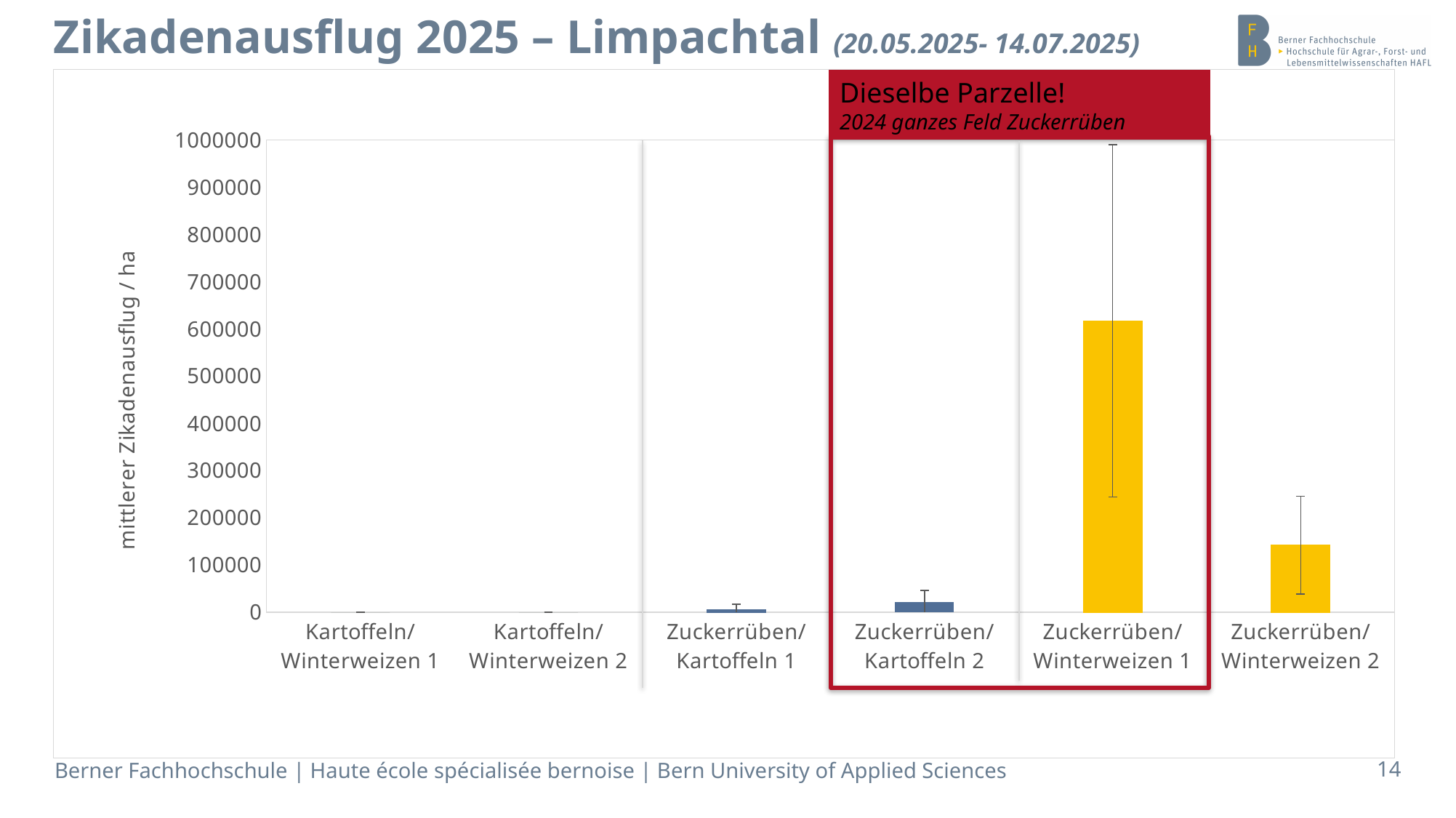
Is the value for Zuckerrüben/Winterweizen 2 greater or less than 200000? less Which is larger, the value for Zuckerrüben/Winterweizen 1 or Zuckerrüben/Winterweizen 2? Zuckerrüben/Winterweizen 1 Is the value for Zuckerrüben/Winterweizen 1 greater or less than 700000? less Which is larger, the value for Zuckerrüben/Kartoffeln 2 or Zuckerrüben/Winterweizen 2? Zuckerrüben/Winterweizen 2 Is the value for Zuckerrüben/Winterweizen 1 greater or less than 500000? greater What is the label of the y axis of the chart? mittlerer Zikadenausflug / ha What colour are the bars for the Zuckerrüben/Winterweizen categories? yellow Which category has the highest mean Zikadenausflug / ha? Zuckerrüben/Winterweizen 1 What kind of chart is shown on the slide? bar chart How many categories are shown on the x axis of the chart? 6